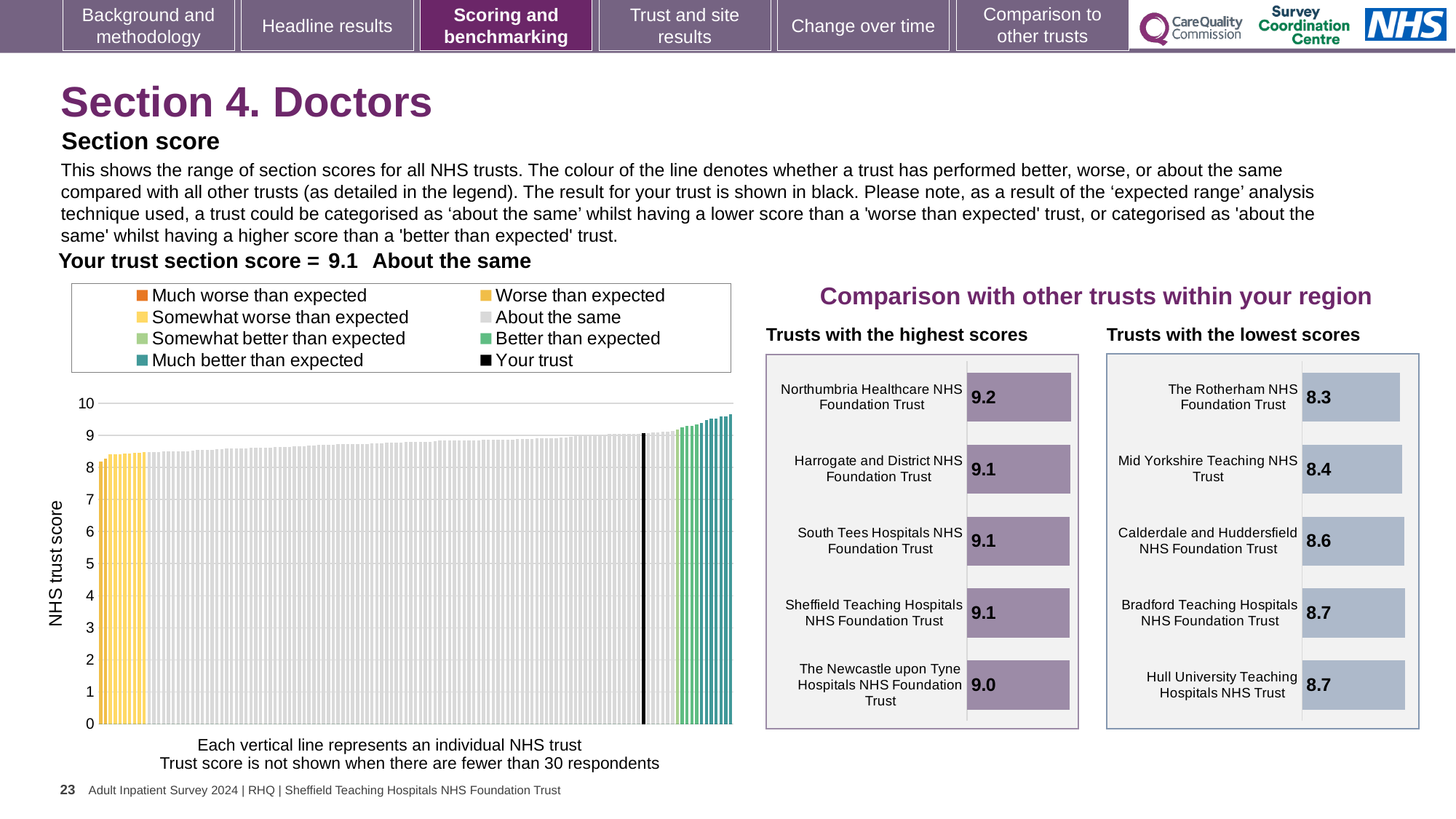
In the 'Trusts with the highest scores' chart, how many trusts are listed? 5 In the 'Trusts with the lowest scores' chart, which is larger: the score for Mid Yorkshire Teaching NHS Trust or Bradford Teaching Hospitals NHS Foundation Trust? Bradford Teaching Hospitals NHS Foundation Trust In the left-hand NHS trust score chart, is the value of the leftmost bar greater or less than 9? less In the 'Trusts with the highest scores' chart, what is the score for Northumbria Healthcare NHS Foundation Trust? 9.2 In the 'Trusts with the highest scores' chart, which trust has the lowest score? The Newcastle upon Tyne Hospitals NHS Foundation Trust In the 'Trusts with the lowest scores' chart, what is the score for Calderdale and Huddersfield NHS Foundation Trust? 8.6 What type of chart is the large chart on the left showing NHS trust scores? Bar chart In the left-hand NHS trust score chart, do the values rise or fall from left to right? Rise In the 'Trusts with the lowest scores' chart, what is the difference between the scores of Hull University Teaching Hospitals NHS Trust and The Rotherham NHS Foundation Trust? 0.4 In the 'Trusts with the lowest scores' chart, which trust has the lowest score? The Rotherham NHS Foundation Trust How many entries does the legend of the left-hand NHS trust score chart list? 8 In the 'Trusts with the highest scores' chart, what is the difference between the scores of Northumbria Healthcare NHS Foundation Trust and The Newcastle upon Tyne Hospitals NHS Foundation Trust? 0.2